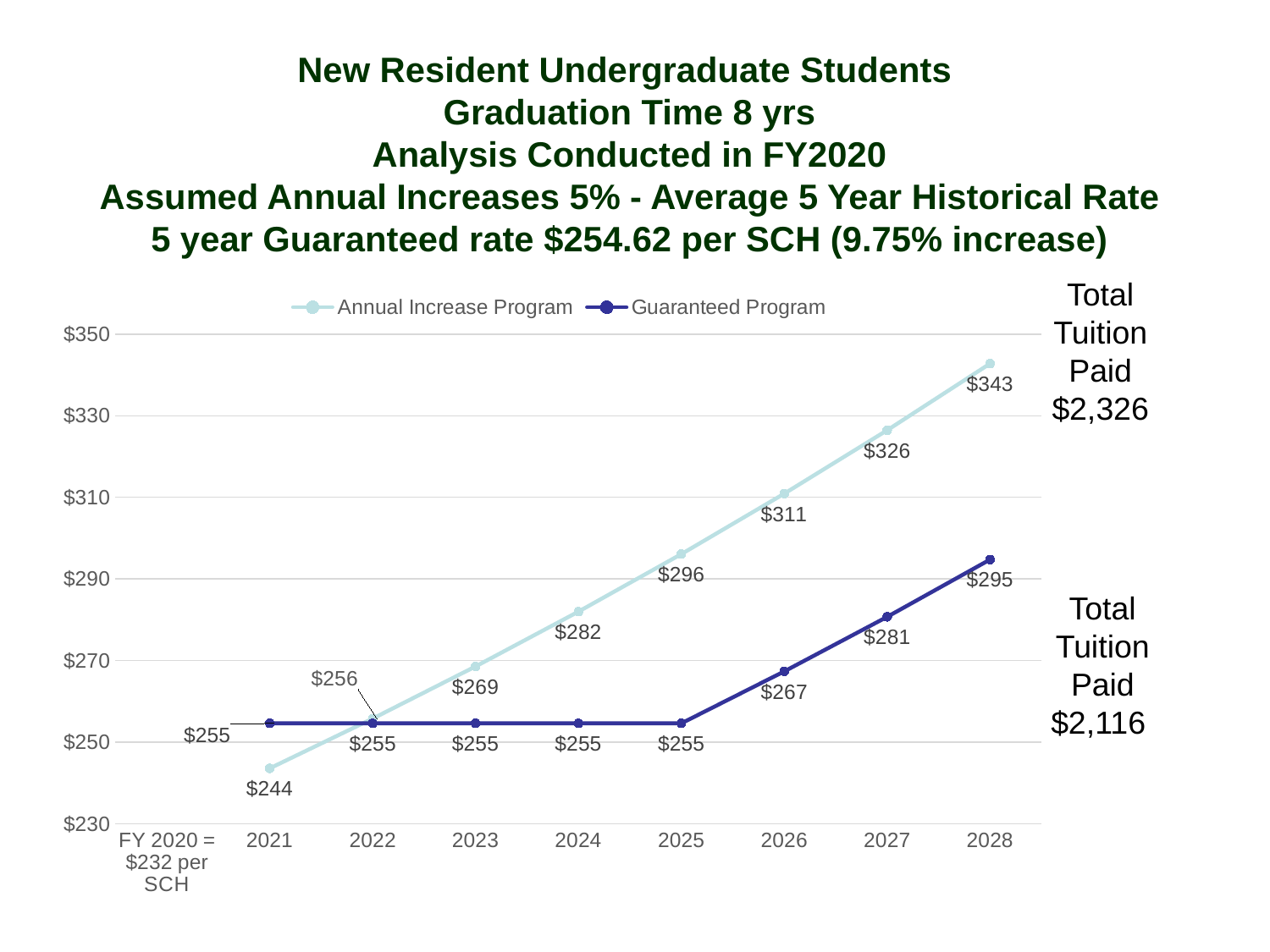
What is the Total Tuition Paid shown for the Annual Increase Program? $2,326 How many data points does the Guaranteed Program line have? 8 What is the value for the Guaranteed Program in 2026? $267 What is the lowest value shown for the Guaranteed Program? $255 In 2021, which series has the higher value, the Annual Increase Program or the Guaranteed Program? Guaranteed Program What is the value for the Annual Increase Program in 2021? $244 In which year does the Annual Increase Program reach its highest value? 2028 What kind of chart is shown on the slide? Line chart How many series does the legend list? 2 What is the difference between the Annual Increase Program and the Guaranteed Program in 2028? $48 Is the value for the Annual Increase Program in 2026 greater or less than $310? greater What is the value for the Annual Increase Program in 2028? $343